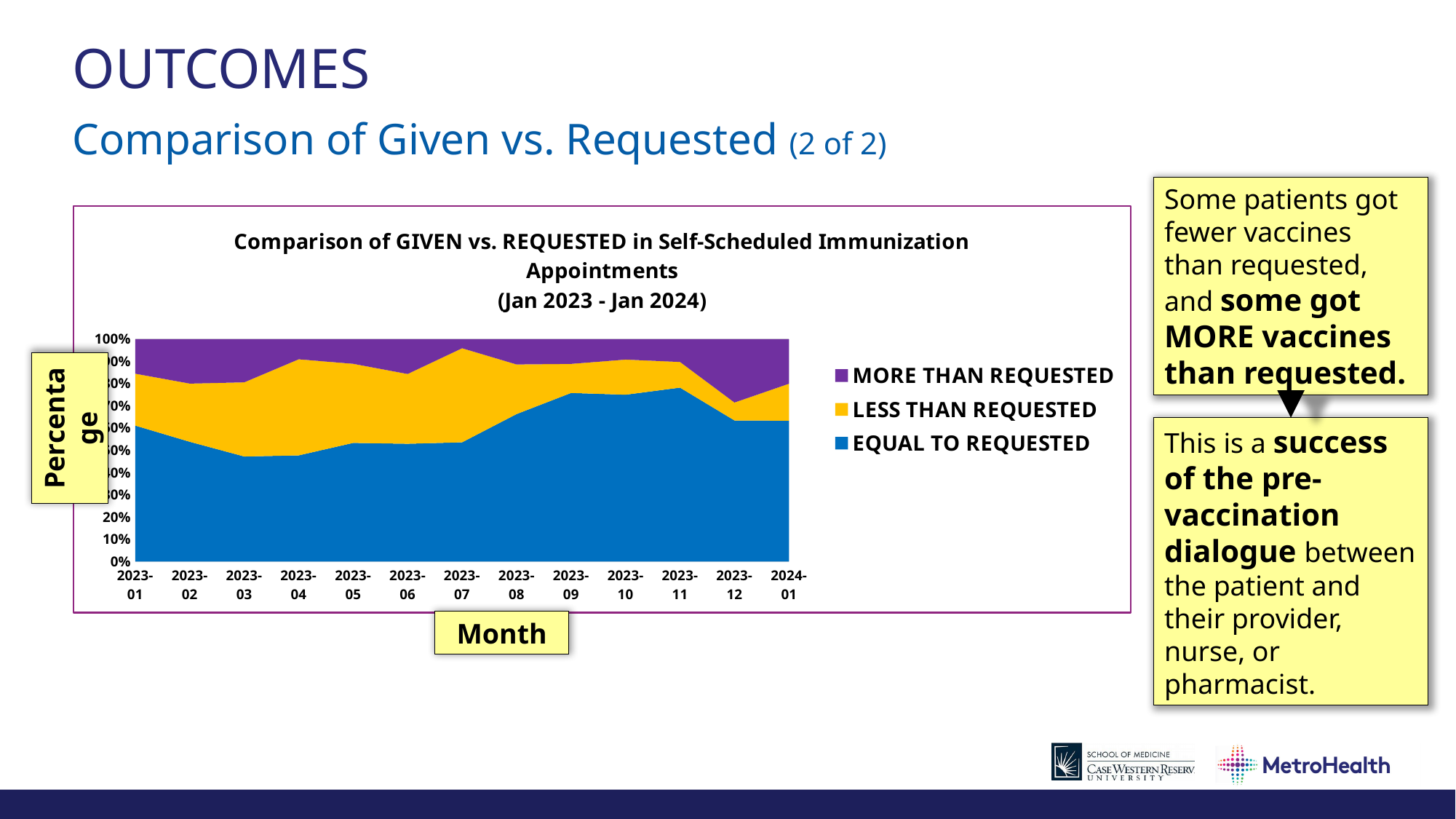
Does the EQUAL TO REQUESTED share rise or fall from 2023-06 to 2023-11? rise Which series has the largest share in 2023-01? EQUAL TO REQUESTED What label is shown on the x axis of the chart? Month How many series does the chart's legend list? 3 Is the value for EQUAL TO REQUESTED in 2023-01 greater or less than 50%? greater Which is larger, the EQUAL TO REQUESTED share in 2023-11 or in 2023-03? 2023-11 What kind of chart is shown on the slide? Area chart How many months are plotted along the x axis of the chart? 13 Is the value for EQUAL TO REQUESTED in 2023-09 greater or less than 70%? greater Is the value for EQUAL TO REQUESTED in 2023-12 greater or less than 50%? greater Which series is listed first in the chart's legend? MORE THAN REQUESTED